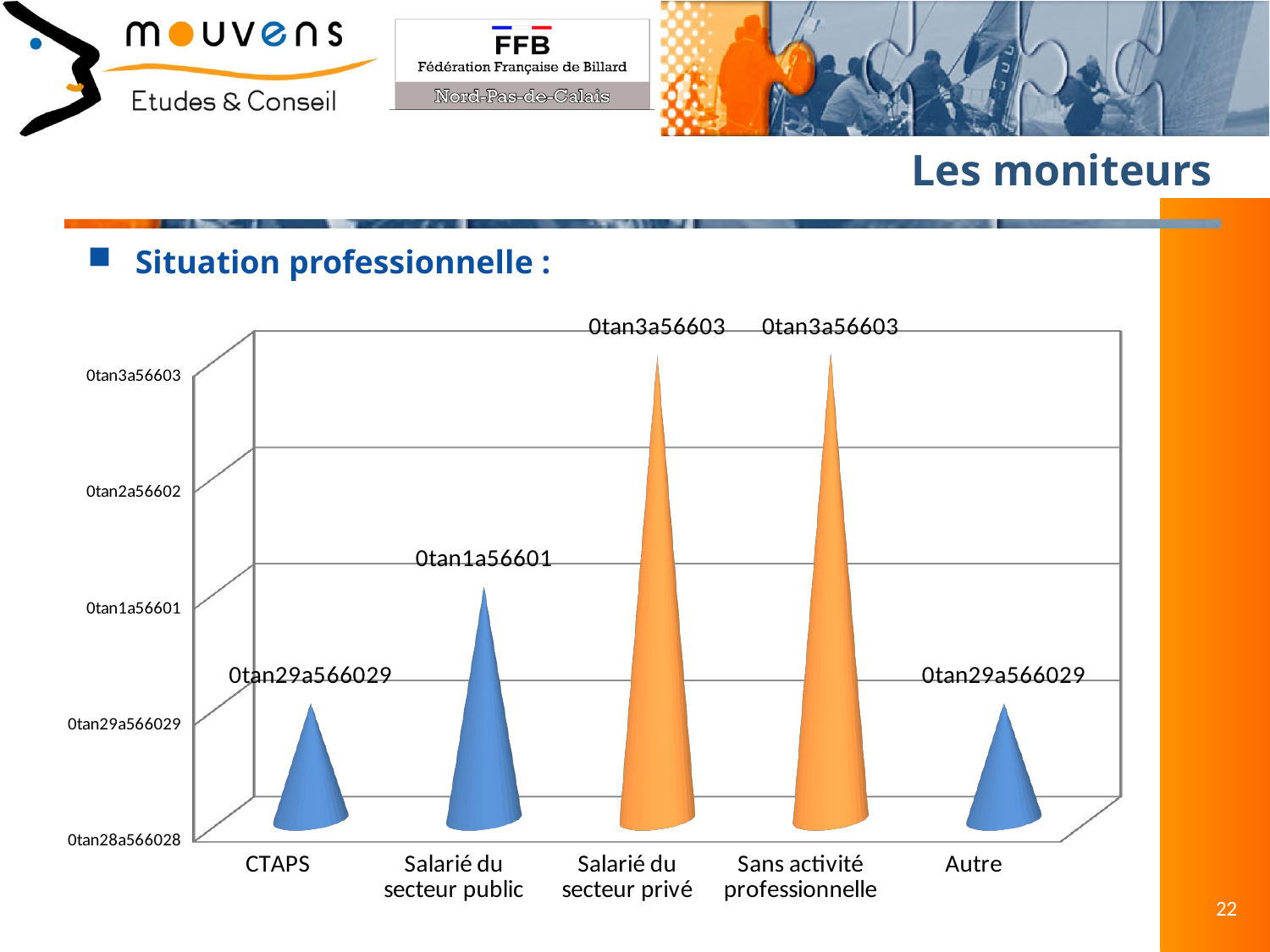
How many categories are shown on the x axis of the chart? 5 What colour are the bars for Salarié du secteur privé and Sans activité professionnelle? orange Which is larger, the value for Salarié du secteur public or the value for Autre? Salarié du secteur public What is the label of the first category on the x axis? CTAPS Which is larger, the value for Sans activité professionnelle or the value for Salarié du secteur public? Sans activité professionnelle What is the heading above the chart? Situation professionnelle Which is larger, the value for Salarié du secteur privé or the value for Autre? Salarié du secteur privé What kind of chart is shown on the slide? bar chart